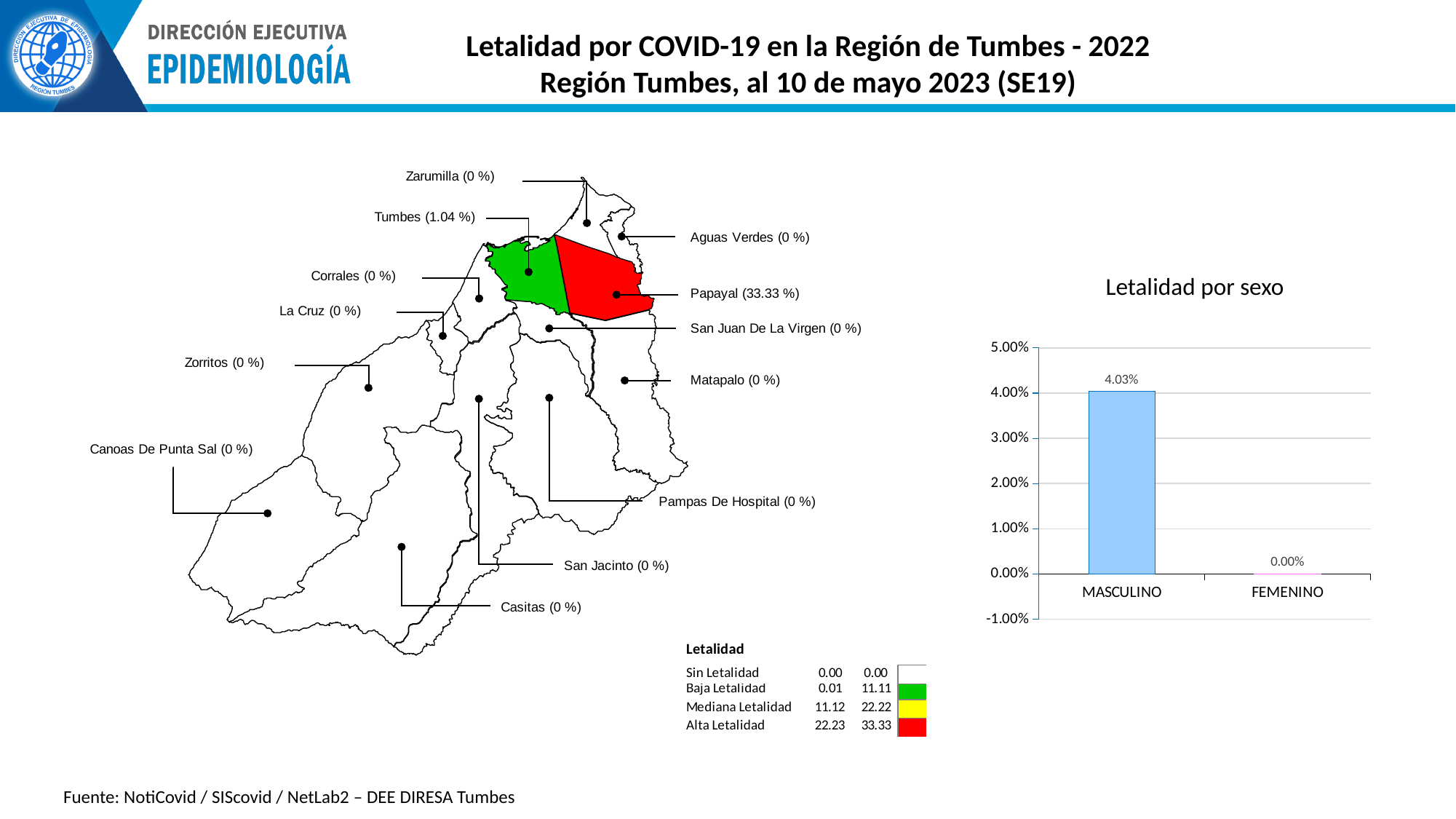
In the 'Letalidad por sexo' chart, which category has the lowest value? FEMENINO What kind of chart is 'Letalidad por sexo'? bar chart In the 'Letalidad por sexo' chart, which category has the highest value? MASCULINO In the 'Letalidad por sexo' chart, is the value for MASCULINO greater or less than 3.00%? greater How many categories are shown in the 'Letalidad por sexo' chart? 2 On the map on the left, what lethality percentage is shown for Papayal? 33.33 % On the map on the left, which district has the highest lethality percentage? Papayal In the 'Letalidad por sexo' chart, what is the value for MASCULINO? 4.03% In the map legend, which colour represents 'Alta Letalidad'? red In the 'Letalidad por sexo' chart, what is the value for FEMENINO? 0.00% In the 'Letalidad por sexo' chart, what is the difference between the MASCULINO and FEMENINO values? 4.03% On the map on the left, what lethality percentage is shown for Tumbes? 1.04 %